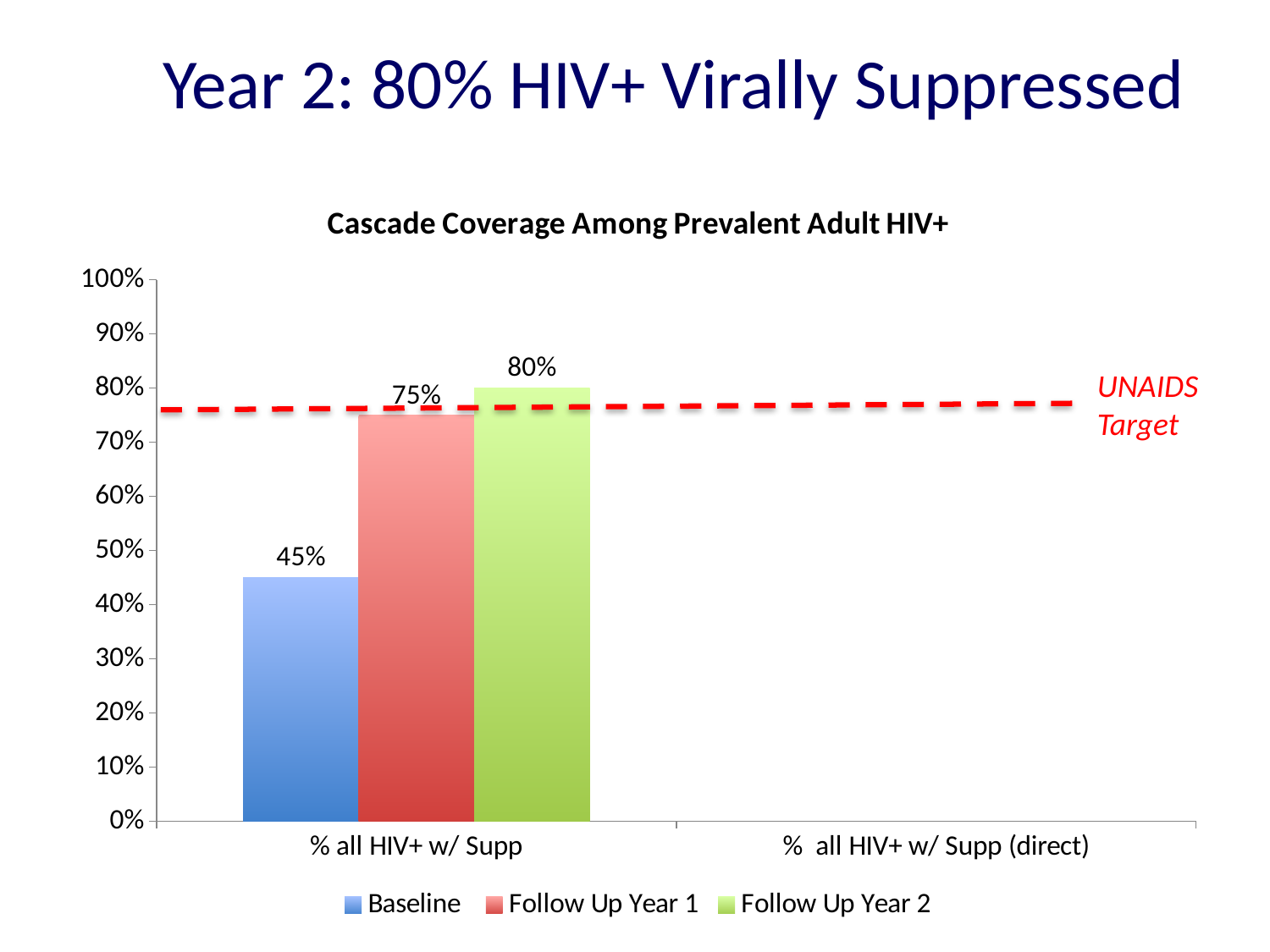
Which is larger for % all HIV+ w/ Supp: the Baseline value or the Follow Up Year 1 value? Follow Up Year 1 What is the difference between the Follow Up Year 2 and Baseline values for % all HIV+ w/ Supp? 35% What is the difference between the Follow Up Year 1 and Baseline values for % all HIV+ w/ Supp? 30% What is the title of the chart? Cascade Coverage Among Prevalent Adult HIV+ What is the Baseline value for % all HIV+ w/ Supp? 45% How many series does the legend list? 3 Is the Baseline value for % all HIV+ w/ Supp greater or less than 50%? less What is the Follow Up Year 2 value for % all HIV+ w/ Supp? 80% Which series has the highest value for % all HIV+ w/ Supp? Follow Up Year 2 Which series has the lowest value for % all HIV+ w/ Supp? Baseline What kind of chart is shown on the slide? bar chart What is the Follow Up Year 1 value for % all HIV+ w/ Supp? 75%